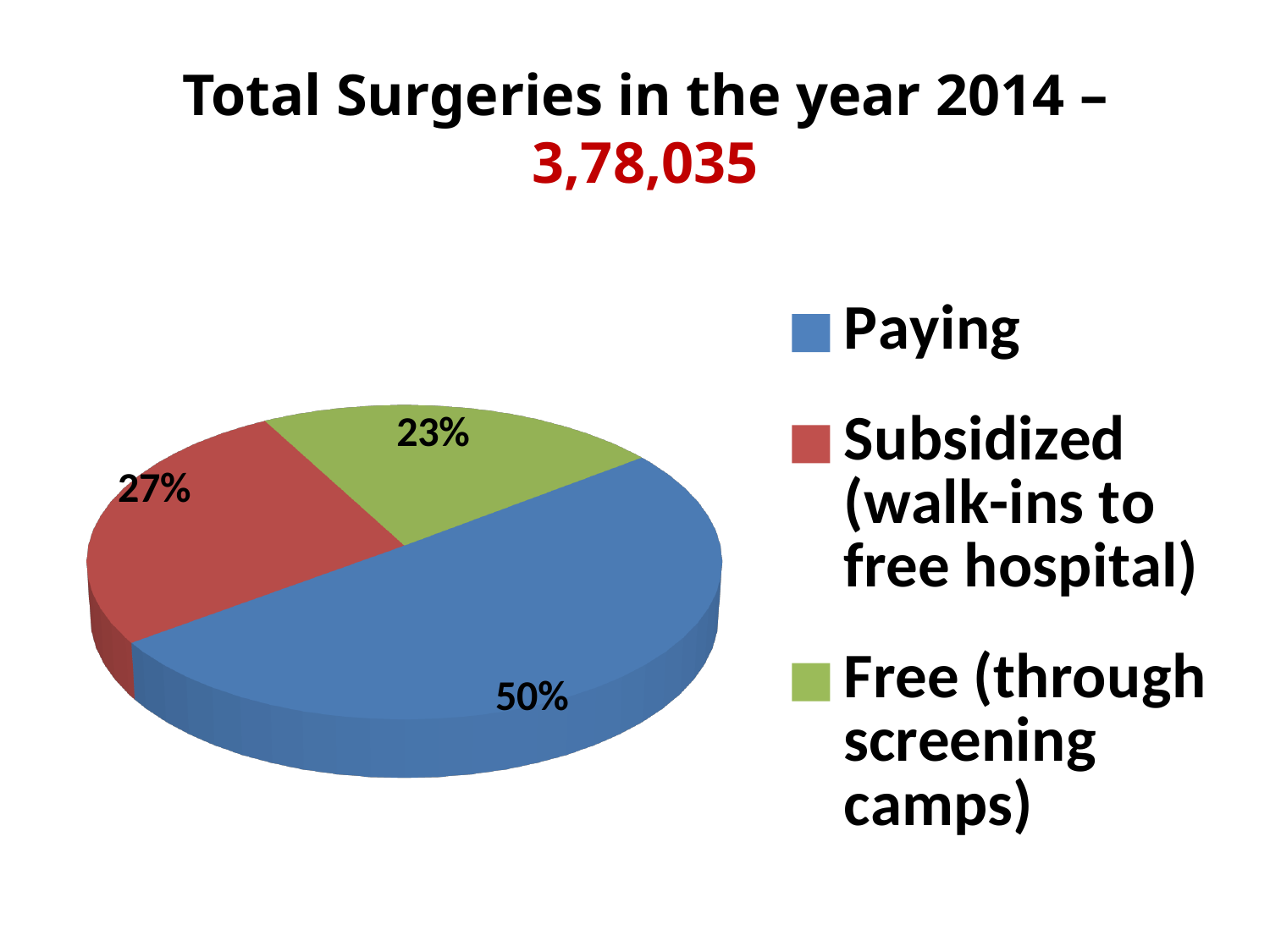
What share of surgeries is labelled for the Paying slice? 50% Which is larger, the Subsidized slice or the Free (through screening camps) slice? Subsidized What colour is the Paying slice of the pie? blue How many categories does the pie chart show? 3 Which category has the smallest slice of the pie? Free (through screening camps) What share of surgeries is labelled for the Free (through screening camps) slice? 23% What total number of surgeries in 2014 is stated in the slide title? 3,78,035 What kind of chart is shown on the slide? pie chart What is the difference in percentage points between the Paying slice and the Subsidized slice? 23 What share of surgeries is labelled for the Subsidized (walk-ins to free hospital) slice? 27% Which category has the largest slice of the pie? Paying What is the difference in percentage points between the Subsidized slice and the Free (through screening camps) slice? 4